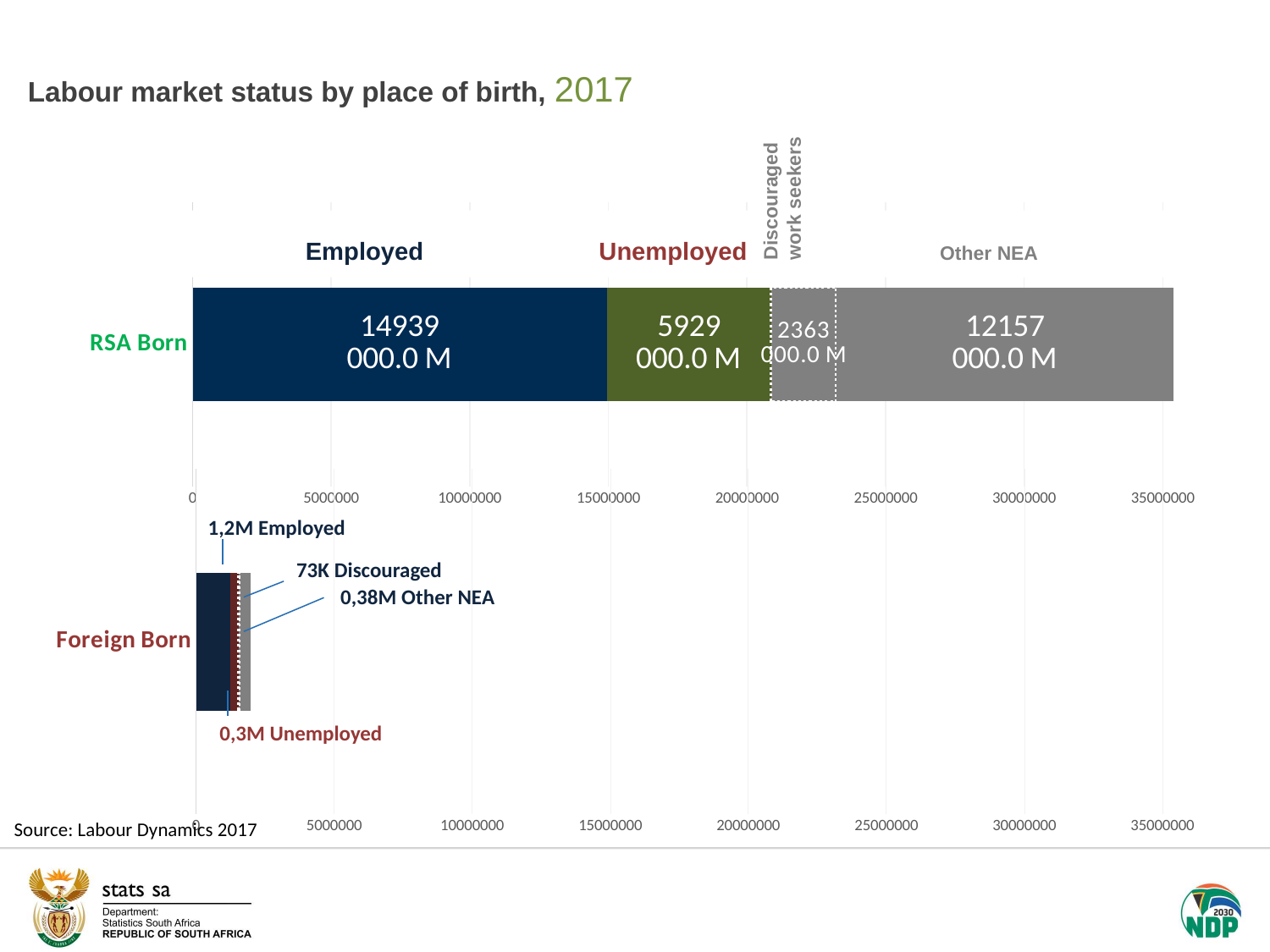
On the RSA Born chart, which labour market status has the largest segment? Employed On the Foreign Born chart, what is the labelled value for Other NEA? 0,38M On the RSA Born chart, is the total length of the stacked bar greater or less than 30000000? greater On the Foreign Born chart, what is the labelled value for Discouraged? 73K On the RSA Born chart, which labour market status has the smallest segment? Discouraged work seekers On the Foreign Born chart, what is the labelled value for Employed? 1,2M On the RSA Born chart, what is the value printed on the Unemployed segment? 5929 000.0 M On the Foreign Born chart, which labour market status has the smallest labelled value? Discouraged On the RSA Born chart, what is the value printed on the Other NEA segment? 12157 000.0 M What kind of chart is used on this slide? Bar chart On the RSA Born chart, what is the value printed on the Discouraged work seekers segment? 2363 000.0 M On the RSA Born chart, what is the value printed on the Employed segment? 14939 000.0 M